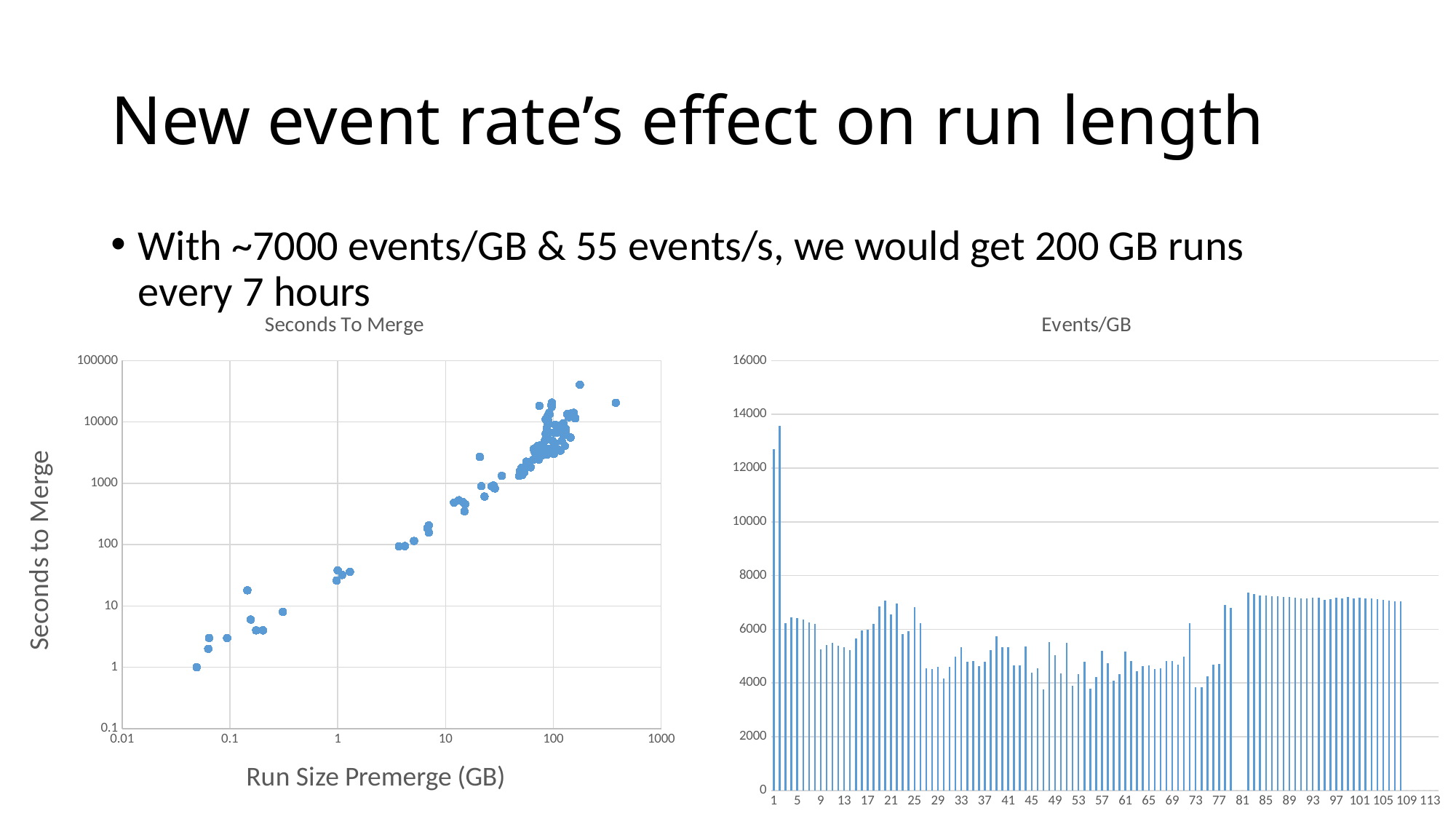
What kind of chart is the right chart titled "Events/GB"? bar chart In the "Seconds To Merge" chart, what is the label of the horizontal axis? Run Size Premerge (GB) In the "Events/GB" chart, is the value for category 49 greater or less than 6000? less What kind of chart is the left chart titled "Seconds To Merge"? scatter chart In the "Events/GB" chart, is the value for category 1 greater or less than 10000? greater In the "Seconds To Merge" chart, do the seconds to merge rise or fall as run size premerge increases? rise In the "Seconds To Merge" chart, is the highest plotted value greater or less than 10000 seconds? greater In the "Seconds To Merge" chart, what is the highest value shown on the vertical axis? 100000 In the "Events/GB" chart, which is larger, the value for category 2 or the value for category 50? category 2